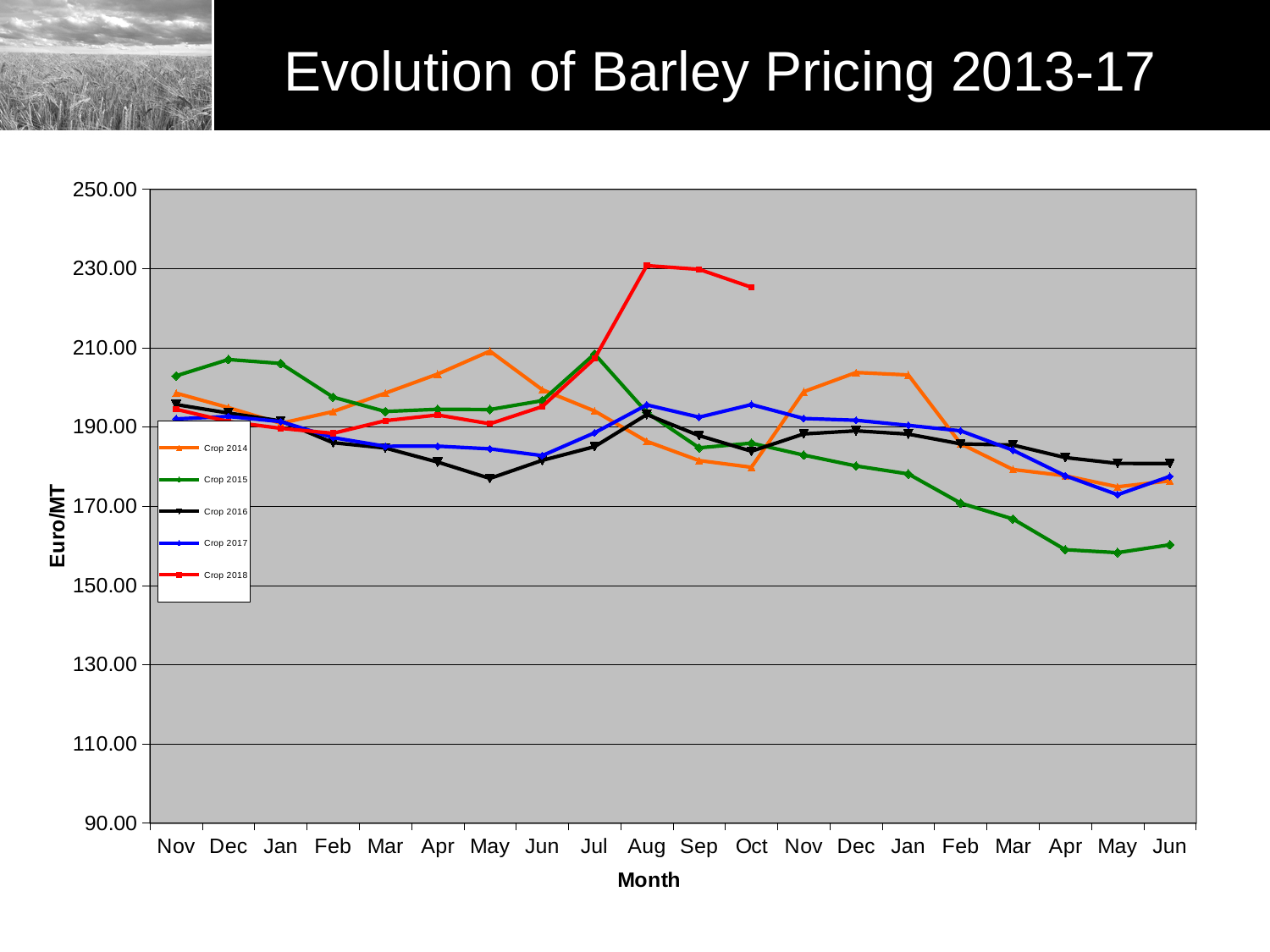
In the final Jun, which is larger: Crop 2014 or Crop 2015? Crop 2014 Which series reaches the highest value on the chart? Crop 2018 In Sep, which is larger: Crop 2018 or Crop 2017? Crop 2018 Is the value for Crop 2016 in the first May greater or less than 190? less Does the Crop 2018 line rise or fall from Jul to Aug? rise How many series does the legend list? 5 What is the label on the y axis? Euro/MT What kind of chart is shown on the slide? Line chart How many month labels are shown along the x axis? 20 Which series falls to the lowest value on the chart? Crop 2015 Is the value for Crop 2018 in Oct greater or less than 210? greater Is the value for Crop 2015 in the second Apr greater or less than 170? less